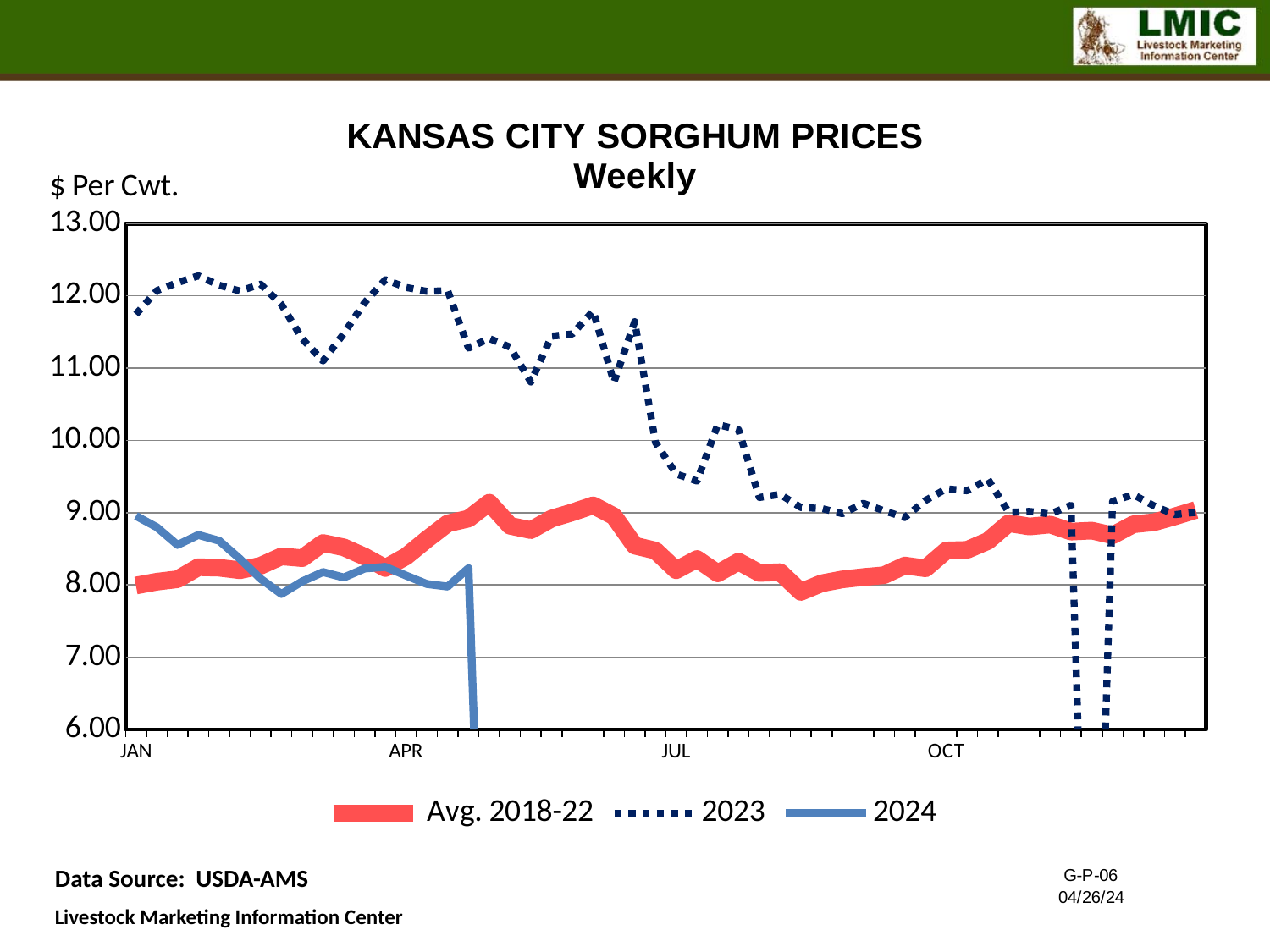
What unit is shown on the y axis label? $ Per Cwt. Does the 2023 series generally rise or fall from JAN to OCT? fall Is the 2023 value in APR greater or less than 11.00? greater How many series does the legend list? 3 Is the 2024 value in JAN greater or less than 8.00? greater In JAN, which is higher: the 2023 series or the Avg. 2018-22 series? 2023 What is the title of the chart? KANSAS CITY SORGHUM PRICES Weekly Is the 2023 value in JAN greater or less than 11.00? greater Which series has the highest value in JAN? 2023 What kind of chart is shown on the slide? line chart